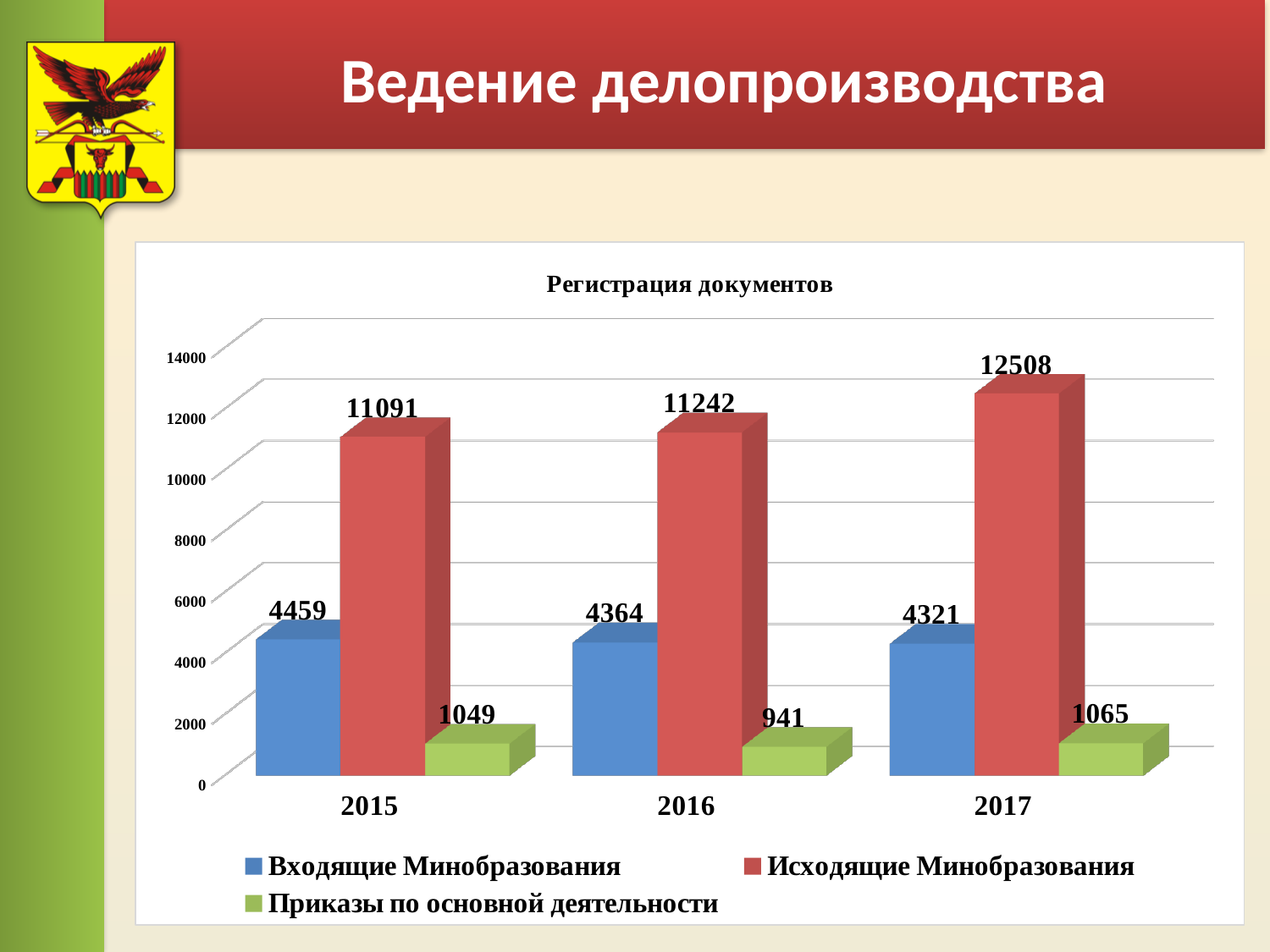
How many series does the legend list? 3 What is the value for Исходящие Минобразования in 2017? 12508 Which is larger: Входящие Минобразования in 2015 or in 2017? 2015 What is the difference between Исходящие Минобразования in 2017 and in 2016? 1266 What is the value for Входящие Минобразования in 2015? 4459 What is the value for Приказы по основной деятельности in 2016? 941 What kind of chart is shown? bar chart In which year is the value for Исходящие Минобразования highest? 2017 In which year is the value for Приказы по основной деятельности lowest? 2016 Is the value for Исходящие Минобразования in 2015 greater or less than 10000? greater How many years are shown on the x axis? 3 Does the value for Входящие Минобразования rise or fall from 2015 to 2017? fall